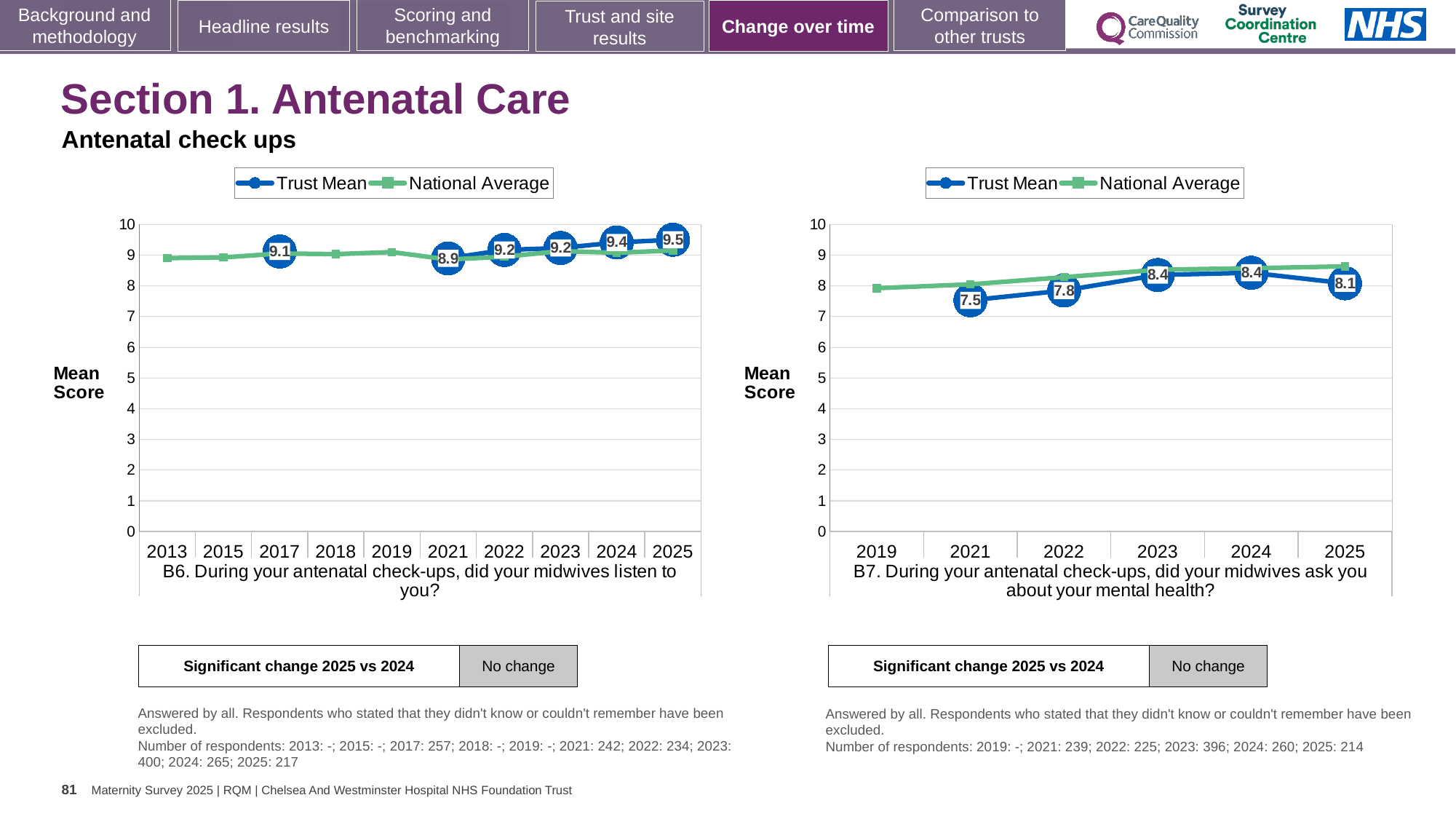
On the B6 chart (left), what is the Trust Mean score for 2025? 9.5 On the B6 chart (left), which year has the highest labelled Trust Mean score? 2025 On the B7 chart (right), which is larger, the Trust Mean score for 2022 or for 2024? 2024 On the B6 chart (left), what is the difference between the Trust Mean scores for 2025 and 2021? 0.6 On the B7 chart (right), what is the Trust Mean score for 2025? 8.1 On the B6 chart (left), which year has the lowest labelled Trust Mean score? 2021 On the B7 chart (right), what is the Trust Mean score for 2021? 7.5 What kind of chart is the B7 chart (right)? Line chart On the B7 chart (right), is the National Average value for 2019 greater or less than 7? greater On the B6 chart (left), what is the Trust Mean score for 2021? 8.9 How many years are shown on the x axis of the B6 chart (left)? 10 How many series does the legend of the B7 chart (right) list? 2